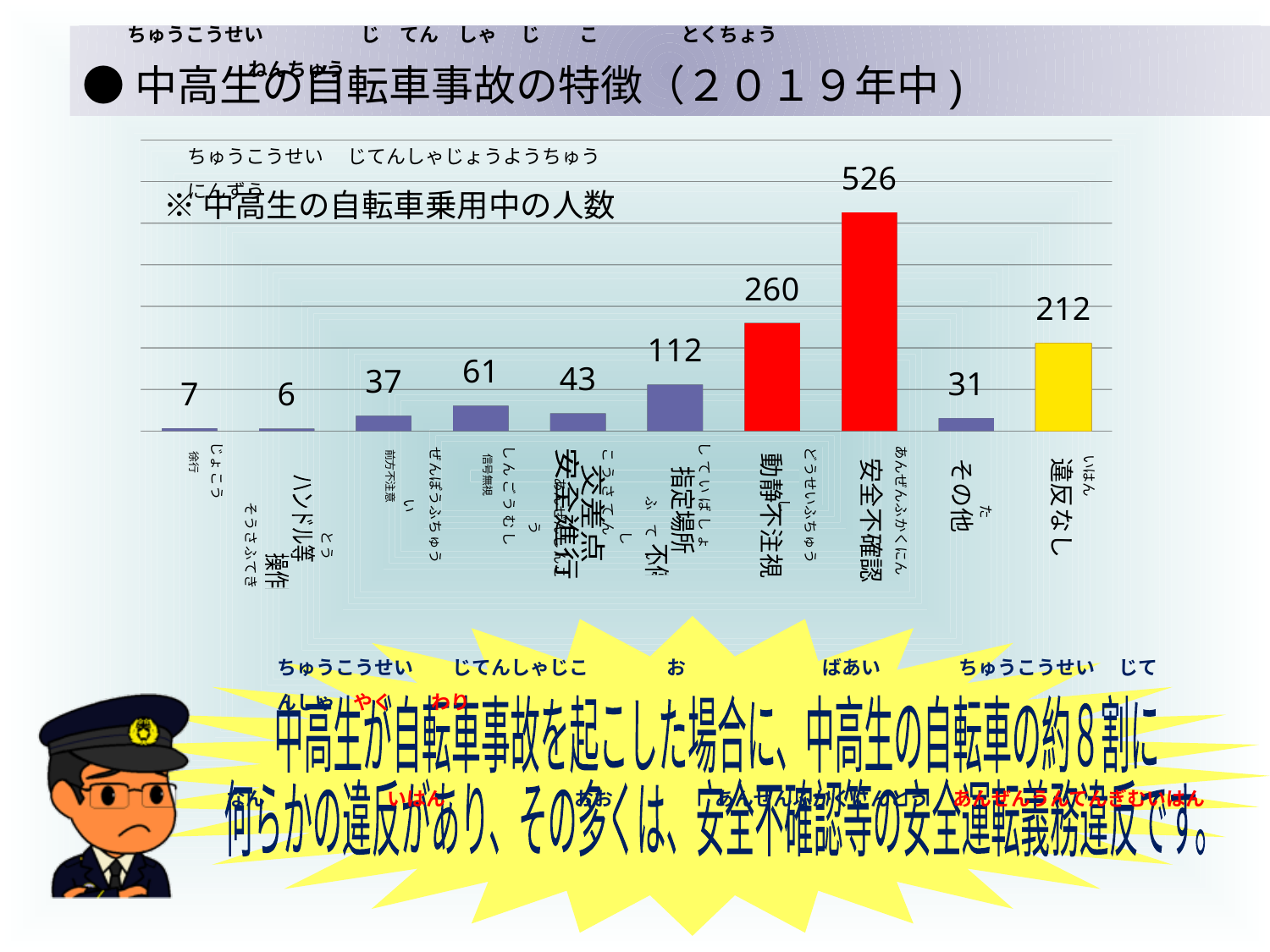
Which category has the lowest value? ハンドル等操作 What type of chart is shown on the slide? bar chart What colour is the bar for 違反なし? yellow Which category has the highest value? 安全不確認 How many categories are shown in the chart? 10 Which is larger, the value for 前方不注意 or the value for 信号無視? 信号無視 What is the difference between the values for 安全不確認 and 動静不注視? 266 What is the value for その他? 31 What is the value for 安全不確認? 526 What is the value for 違反なし? 212 What is the value for 信号無視? 61 What is the value for 動静不注視? 260